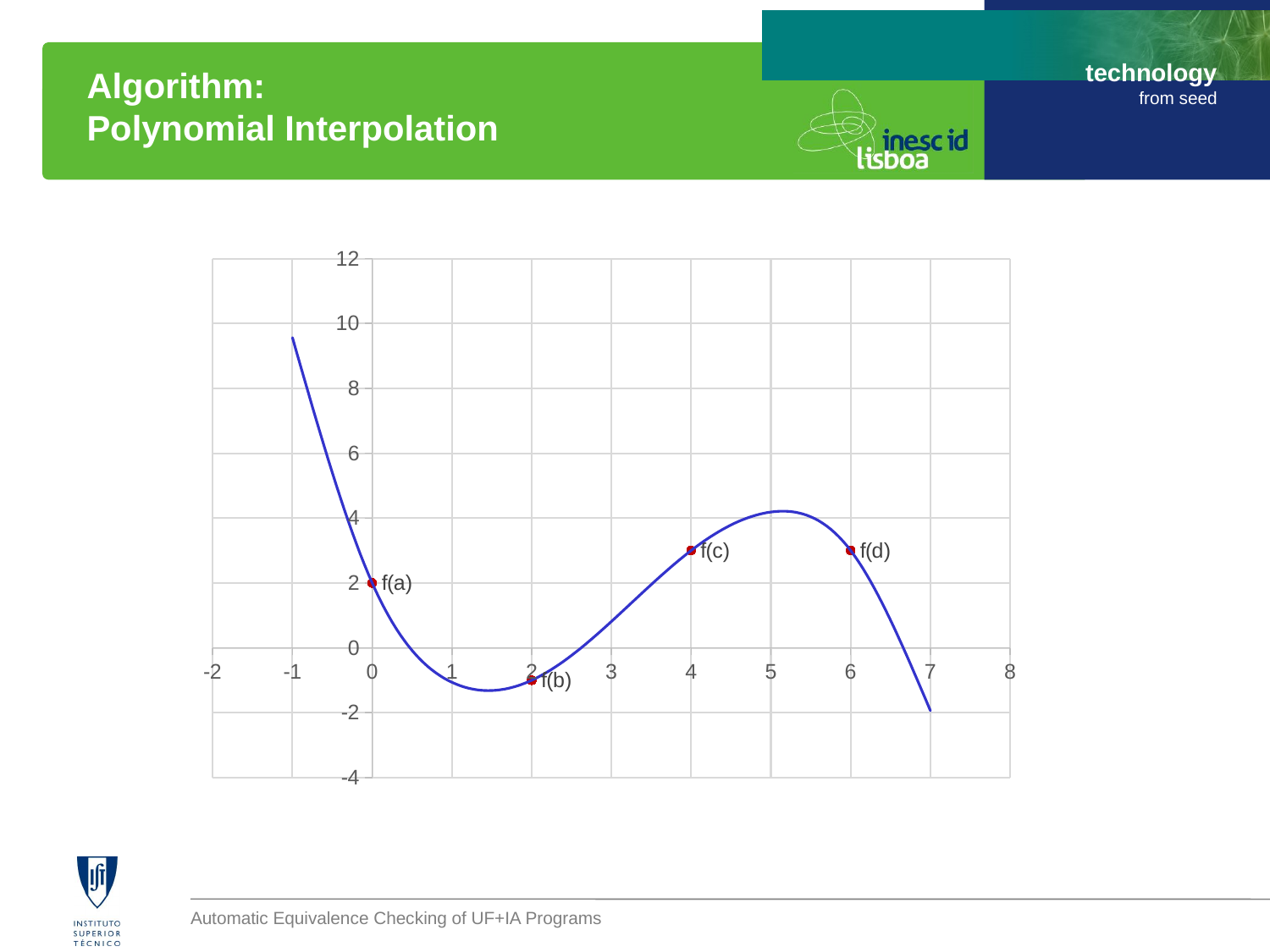
How many labelled points are marked on the curve? 4 Is the y value of the point f(d) greater or less than 4? less What is the y value of the point f(a)? 2 Which has the larger y value, f(a) or f(c)? f(c) Is the y value of the point f(b) greater or less than 0? less At which x value is the point f(d) marked? 6 Which of the marked points has the lowest y value? f(b) Is the y value of the point f(c) greater or less than 2? greater What kind of chart is shown on the slide? line chart What is the highest value shown on the y axis? 12 Does the curve rise or fall between x = 2 and x = 4? rise At which x value is the point f(a) marked? 0